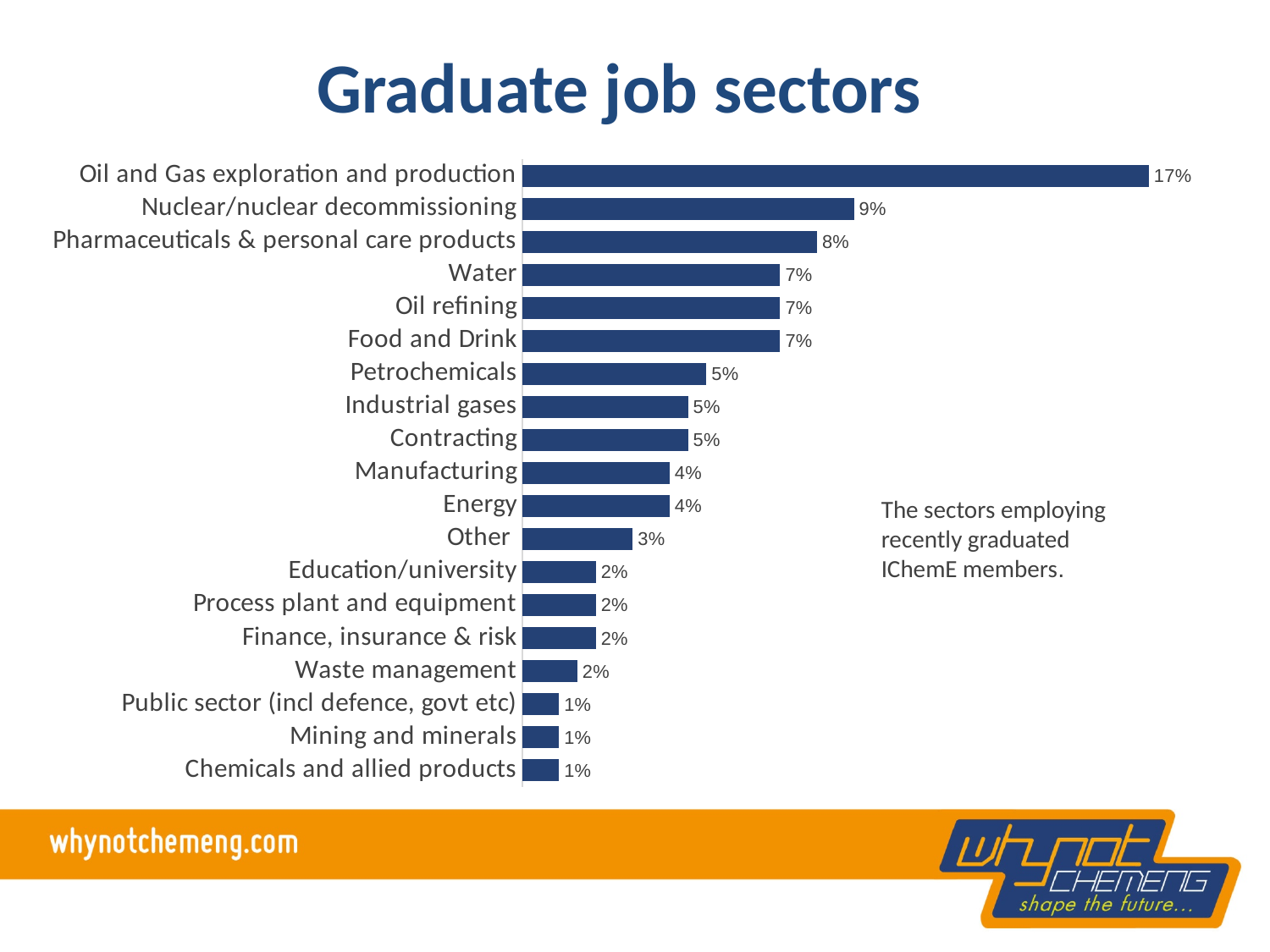
What is the title of the slide? Graduate job sectors What is the value for Petrochemicals? 5% What percentage is shown for Manufacturing? 4% How many sectors are shown in the chart? 19 What is the value for Nuclear/nuclear decommissioning? 9% What is the value for Mining and minerals? 1% What percentage is shown for Pharmaceuticals & personal care products? 8% Which is larger, the value for Water or the value for Petrochemicals? Water What percentage is shown for Oil and Gas exploration and production? 17% Which sector has the highest percentage? Oil and Gas exploration and production What is the difference between the values for Oil and Gas exploration and production and Nuclear/nuclear decommissioning? 8% What kind of chart is shown on the slide? Bar chart